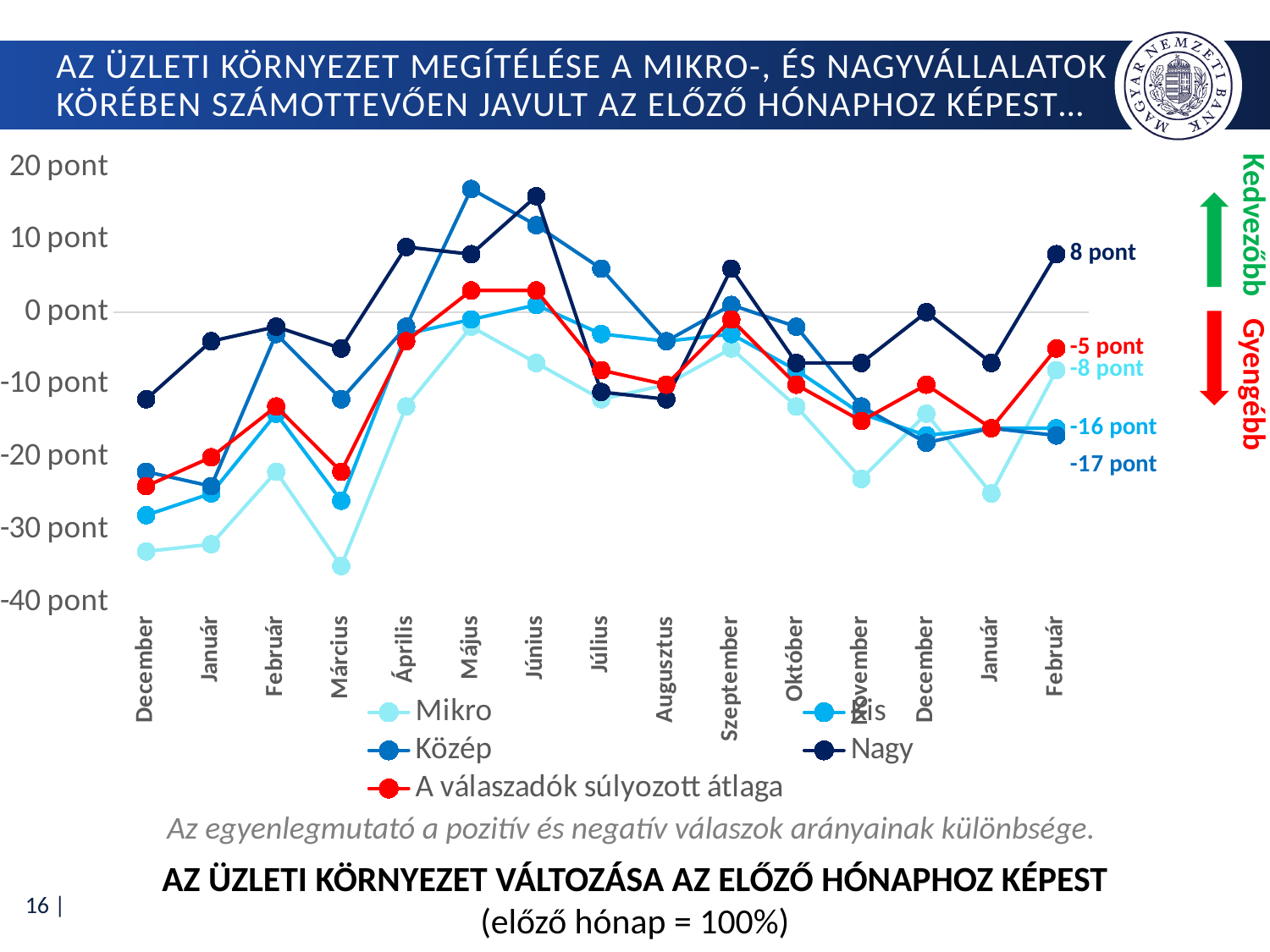
How many series does the legend list? 5 What is the value of the Mikro series in the final Február? -8 pont Which series has the highest value in the final Február? Nagy What type of chart is shown on the slide? line chart In the final Február, which is larger: the Kis value or the Közép value? Kis What is the difference between the Nagy value and the weighted average value in the final Február? 13 pont How many months are shown along the x axis? 15 What is the value of the Közép series in the final Február? -17 pont Is the value for Közép in Május greater or less than 10 pont? greater What is the value of the Nagy series in the final Február? 8 pont Is the value for Mikro in Március greater or less than -30 pont? less What is the value of 'A válaszadók súlyozott átlaga' in the final Február? -5 pont